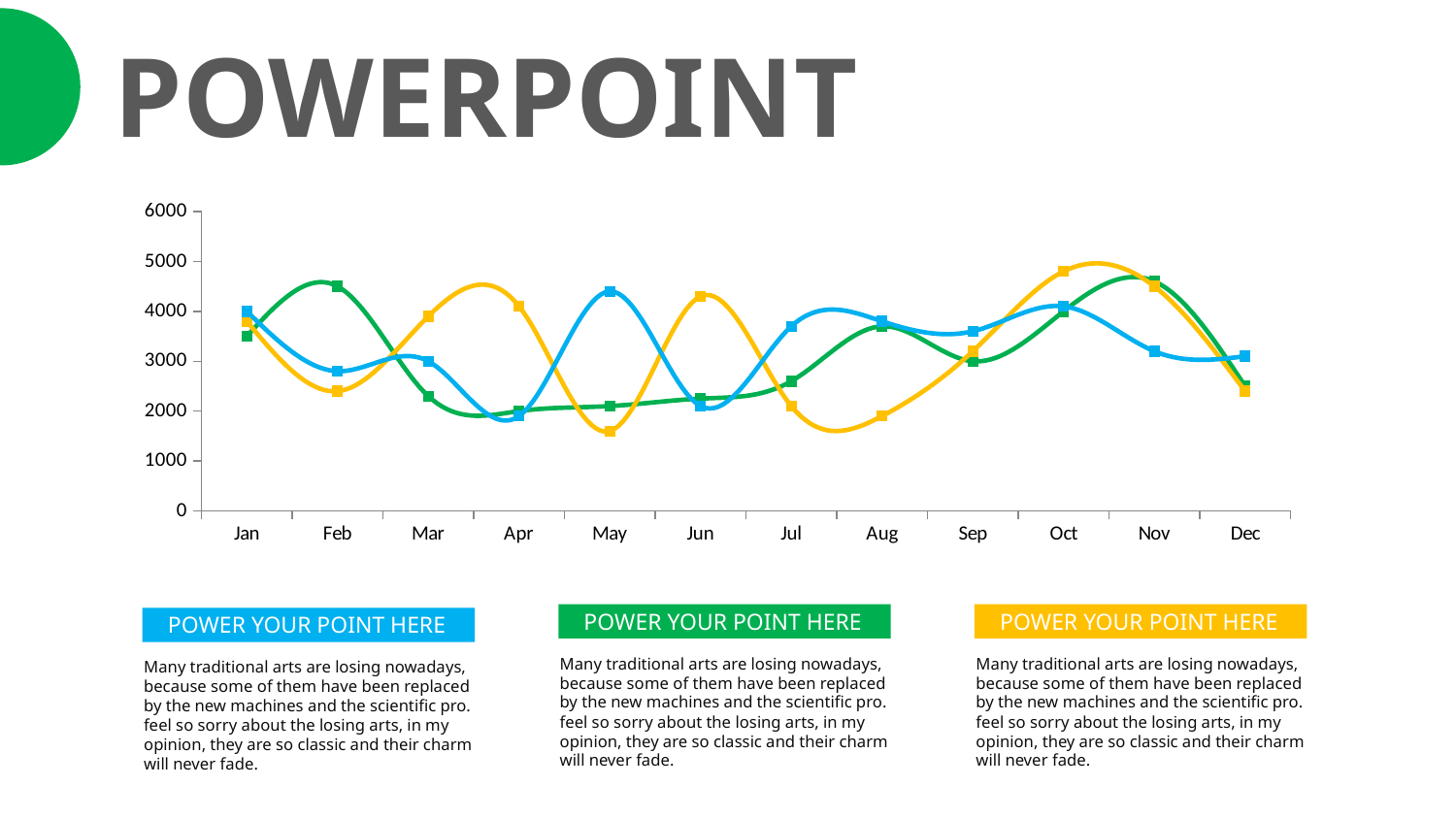
In which month does the yellow line reach its lowest value? May Is the value of the green line in Apr greater or less than 3000? less How many months are shown along the x axis of the chart? 12 Is the value of the green line in Feb greater or less than 4000? greater Is the value of the blue line in May greater or less than 4000? greater How many lines (data series) are plotted on the chart? 3 In Feb, which line has the larger value, the green line or the yellow line? green In which month does the yellow line reach its highest value? Oct What kind of chart is shown on the slide? line chart What is the highest value shown on the y axis of the chart? 6000